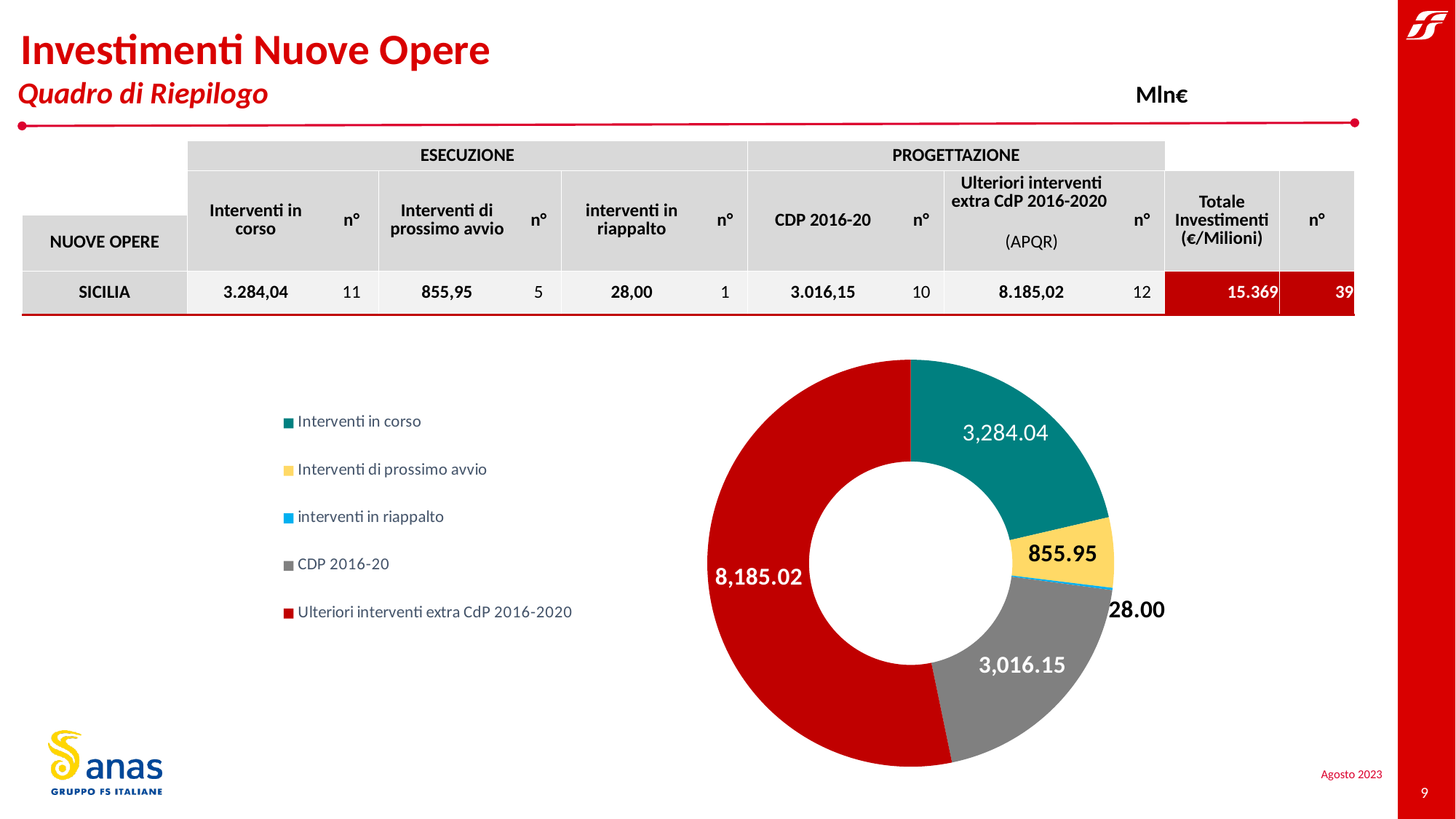
What is the difference between the Interventi in corso value and the CDP 2016-20 value? 267.89 What type of chart is shown on the slide? Doughnut chart Which category has the smallest slice in the chart? interventi in riappalto What is the value of the Interventi in corso slice? 3,284.04 How many categories does the chart legend list? 5 What colour is the Ulteriori interventi extra CdP 2016-2020 slice? Red Which category has the largest slice in the chart? Ulteriori interventi extra CdP 2016-2020 What is the value of the CDP 2016-20 slice? 3,016.15 What is the value of the Ulteriori interventi extra CdP 2016-2020 slice? 8,185.02 Which is larger, Interventi in corso or CDP 2016-20? Interventi in corso What is the value of the Interventi di prossimo avvio slice? 855.95 What is the value of the interventi in riappalto slice? 28.00